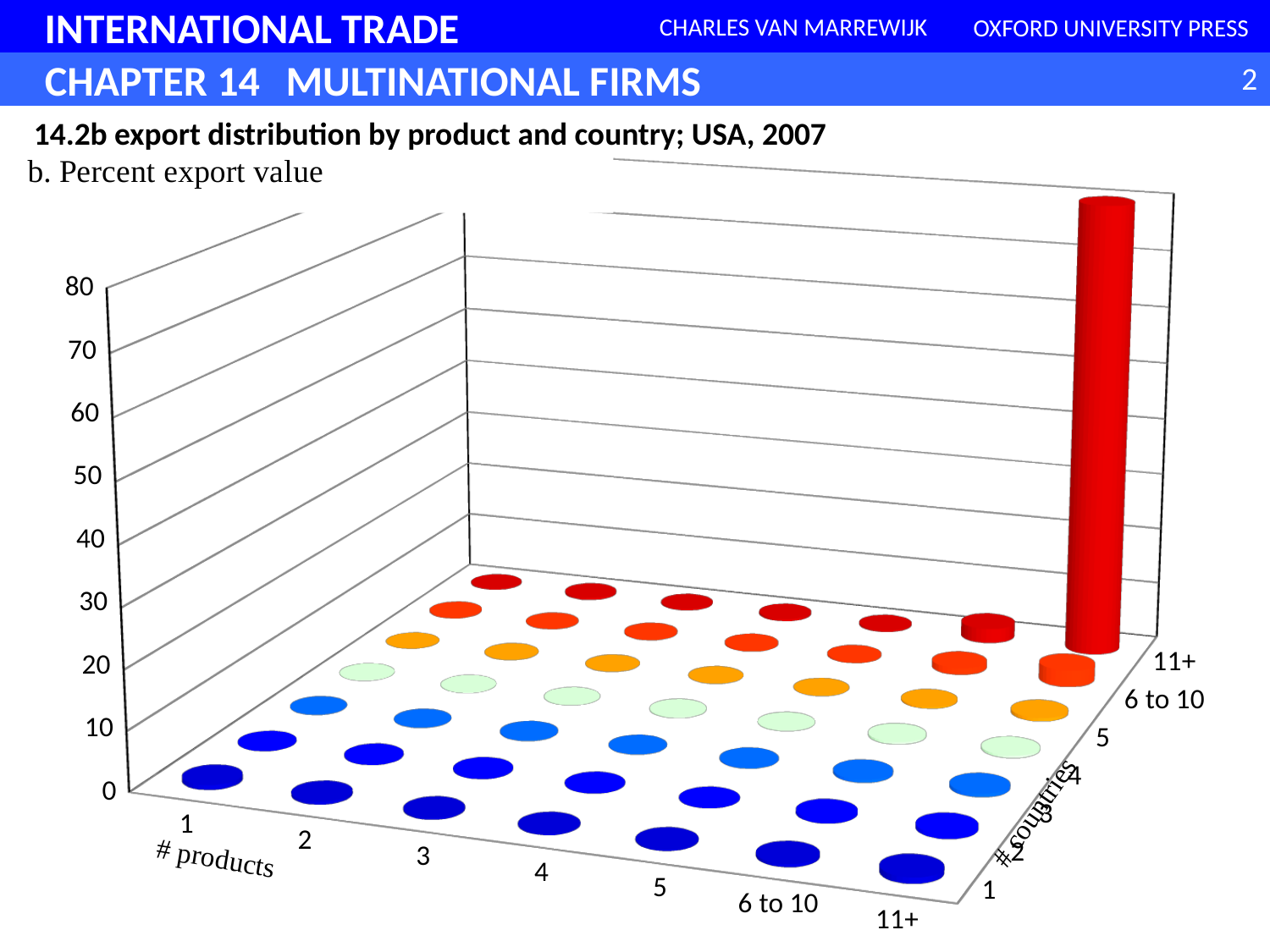
Is the value for 1 product and 1 country greater or less than 10? less Is the value for 11+ products and 11+ countries greater or less than 50? greater Is the value for 6 to 10 products and 6 to 10 countries greater or less than 20? less How many categories are shown on the '# countries' axis? 7 What is the highest tick value shown on the vertical axis? 80 For firms exporting to 11+ countries, do the values rise or fall as the number of products increases from 1 to 11+? rise How many categories are shown on the '# products' axis? 7 What is the title of the chart on the slide? 14.2b export distribution by product and country; USA, 2007 Which combination of # products and # countries has the highest export value? 11+ products and 11+ countries What kind of chart is shown on the slide? bar chart Which is larger: the value for 11+ products and 11+ countries, or the value for 1 product and 1 country? 11+ products and 11+ countries What quantity does the vertical axis of the chart measure, according to the label above it? Percent export value